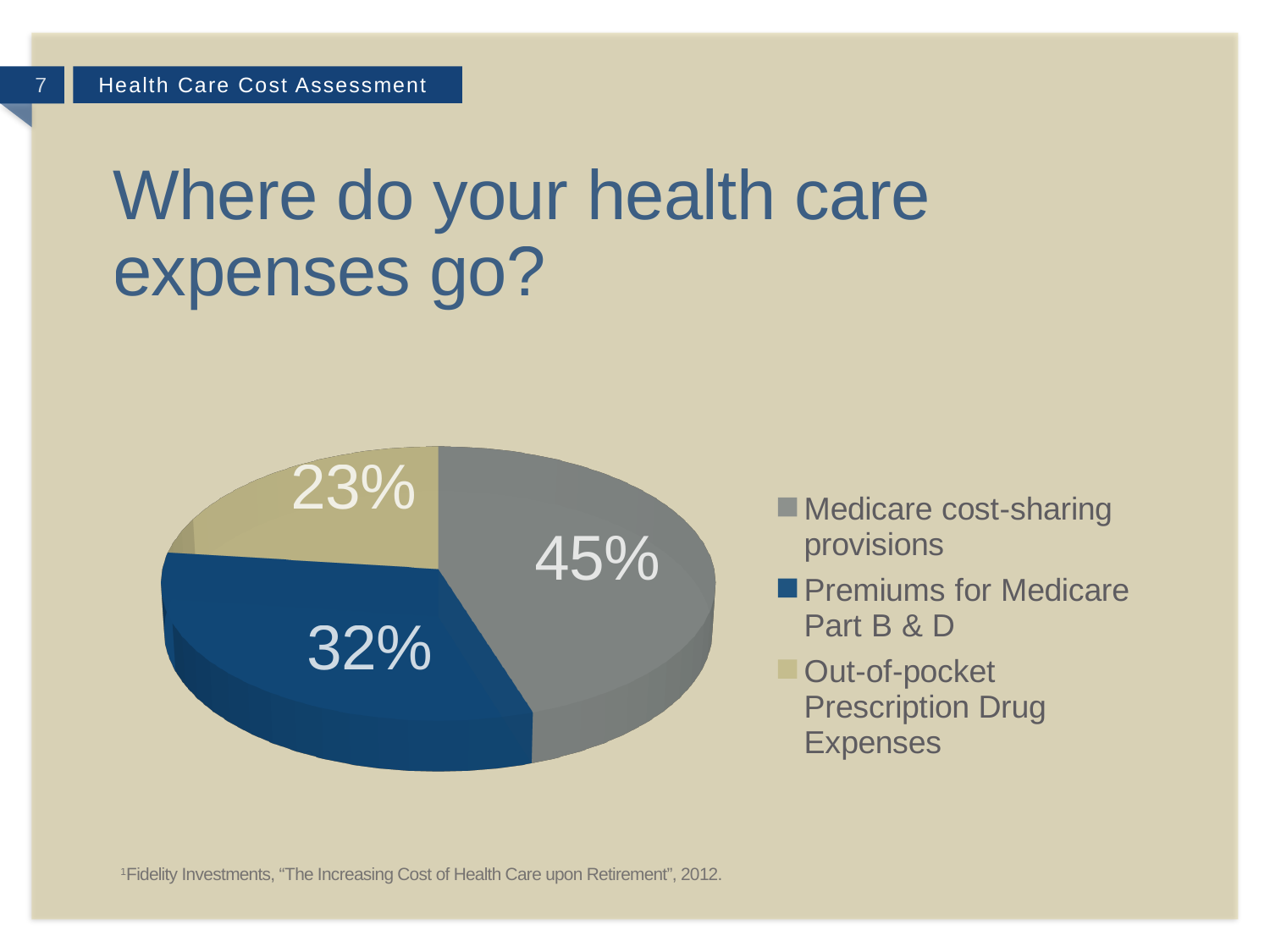
What colour is the slice for Premiums for Medicare Part B & D? Blue How many percentage points larger is the Premiums for Medicare Part B & D slice than the Out-of-pocket Prescription Drug Expenses slice? 9 Which is larger: the share for Premiums for Medicare Part B & D or the share for Out-of-pocket Prescription Drug Expenses? Premiums for Medicare Part B & D How many percentage points larger is the Medicare cost-sharing provisions slice than the Premiums for Medicare Part B & D slice? 13 What share of health care expenses goes to Medicare cost-sharing provisions? 45% How many slices does the pie chart have? 3 What share of health care expenses goes to Out-of-pocket Prescription Drug Expenses? 23% Which category accounts for the largest share of health care expenses? Medicare cost-sharing provisions What kind of chart is shown on the slide? Pie chart What share of health care expenses goes to Premiums for Medicare Part B & D? 32% Which category accounts for the smallest share of health care expenses? Out-of-pocket Prescription Drug Expenses How many entries does the legend list? 3